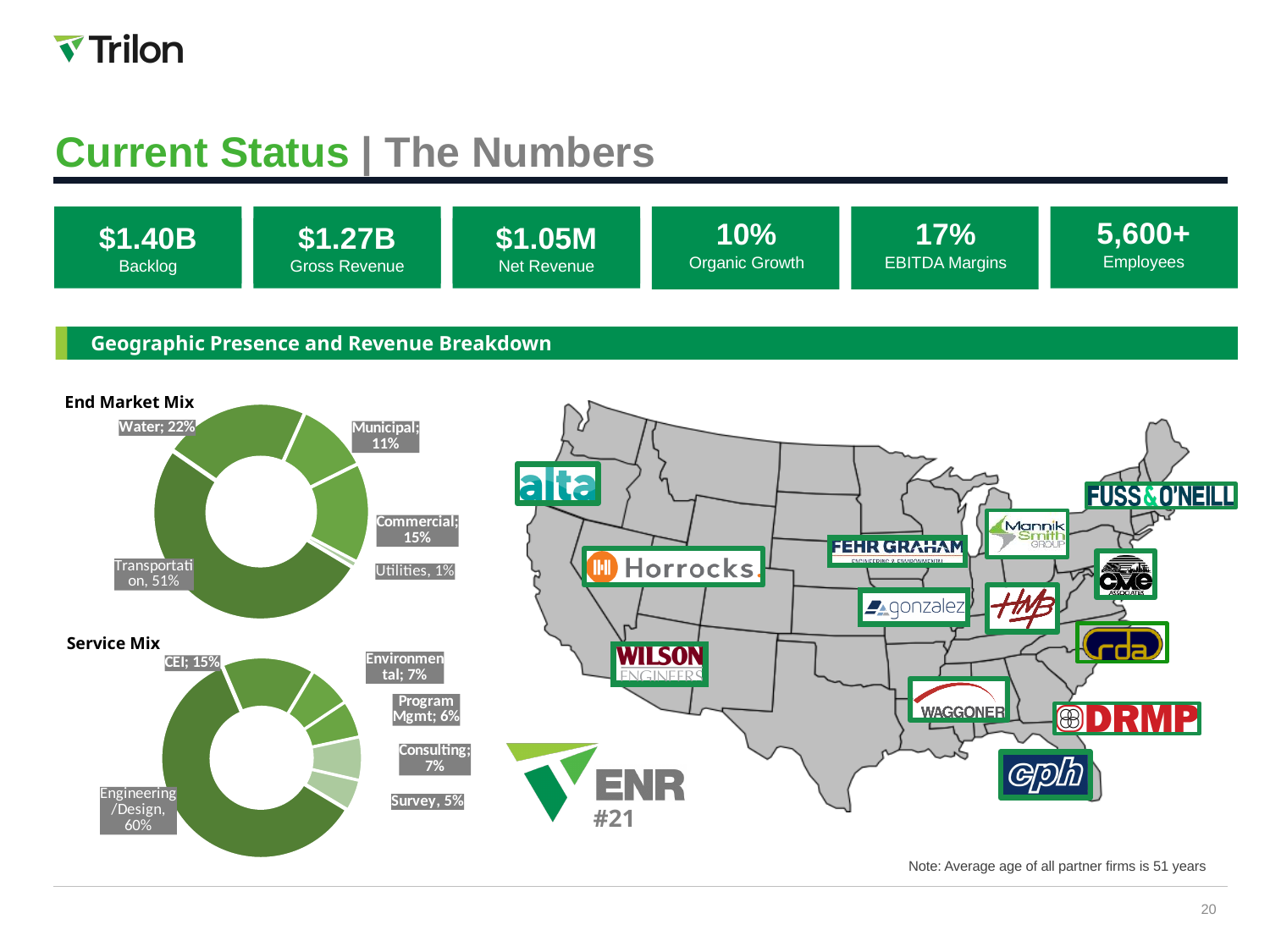
How many categories are shown in the End Market Mix chart? 5 In the End Market Mix chart, what is the difference in percentage points between Commercial and Municipal? 4 In the Service Mix chart, what share does Engineering/Design have? 60% In the Service Mix chart, what share does Program Mgmt have? 6% In the End Market Mix chart, which category has the smallest share? Utilities In the End Market Mix chart, what share does Transportation have? 51% What type of chart is the Service Mix chart? Donut (pie) chart In the End Market Mix chart, which category has the largest share? Transportation In the Service Mix chart, which category has the smallest share? Survey In the End Market Mix chart, what share does Water have? 22% In the Service Mix chart, which is larger, CEI or Consulting? CEI How many categories are shown in the Service Mix chart? 6